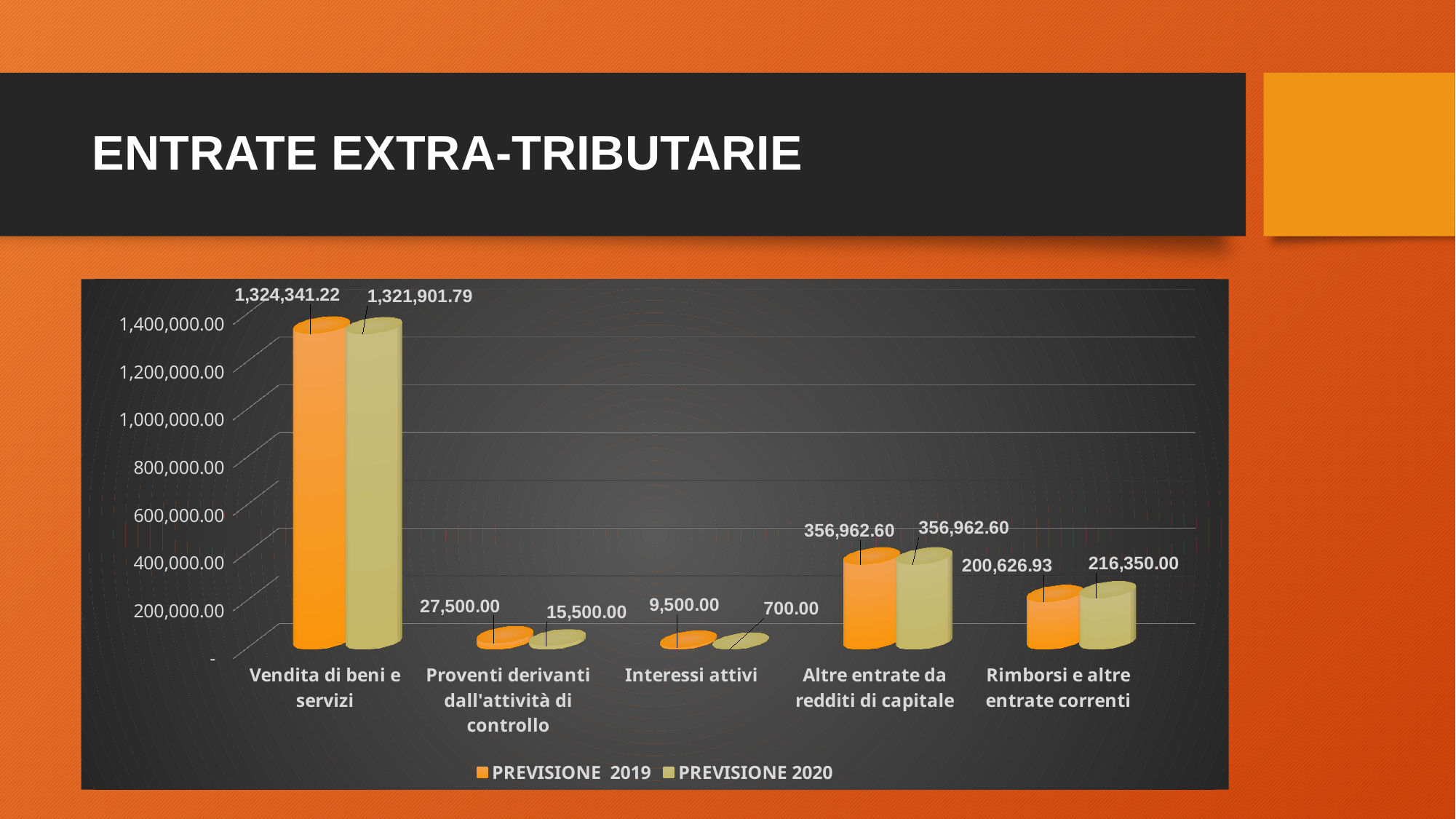
Which category has the lowest PREVISIONE 2019 value? Interessi attivi How many categories are shown on the x axis of the chart? 5 Which category has the highest PREVISIONE 2020 value? Vendita di beni e servizi How many series does the chart legend list? 2 What is the PREVISIONE 2019 value for Proventi derivanti dall'attività di controllo? 27,500.00 What is the PREVISIONE 2020 value for Interessi attivi? 700.00 What is the PREVISIONE 2019 value for Vendita di beni e servizi? 1,324,341.22 What kind of chart is shown on the slide? Bar chart What is the PREVISIONE 2020 value for Rimborsi e altre entrate correnti? 216,350.00 What is the difference between the PREVISIONE 2019 and PREVISIONE 2020 values for Proventi derivanti dall'attività di controllo? 12,000.00 For Rimborsi e altre entrate correnti, which is larger: PREVISIONE 2019 or PREVISIONE 2020? PREVISIONE 2020 What is the difference between the PREVISIONE 2020 and PREVISIONE 2019 values for Rimborsi e altre entrate correnti? 15,723.07